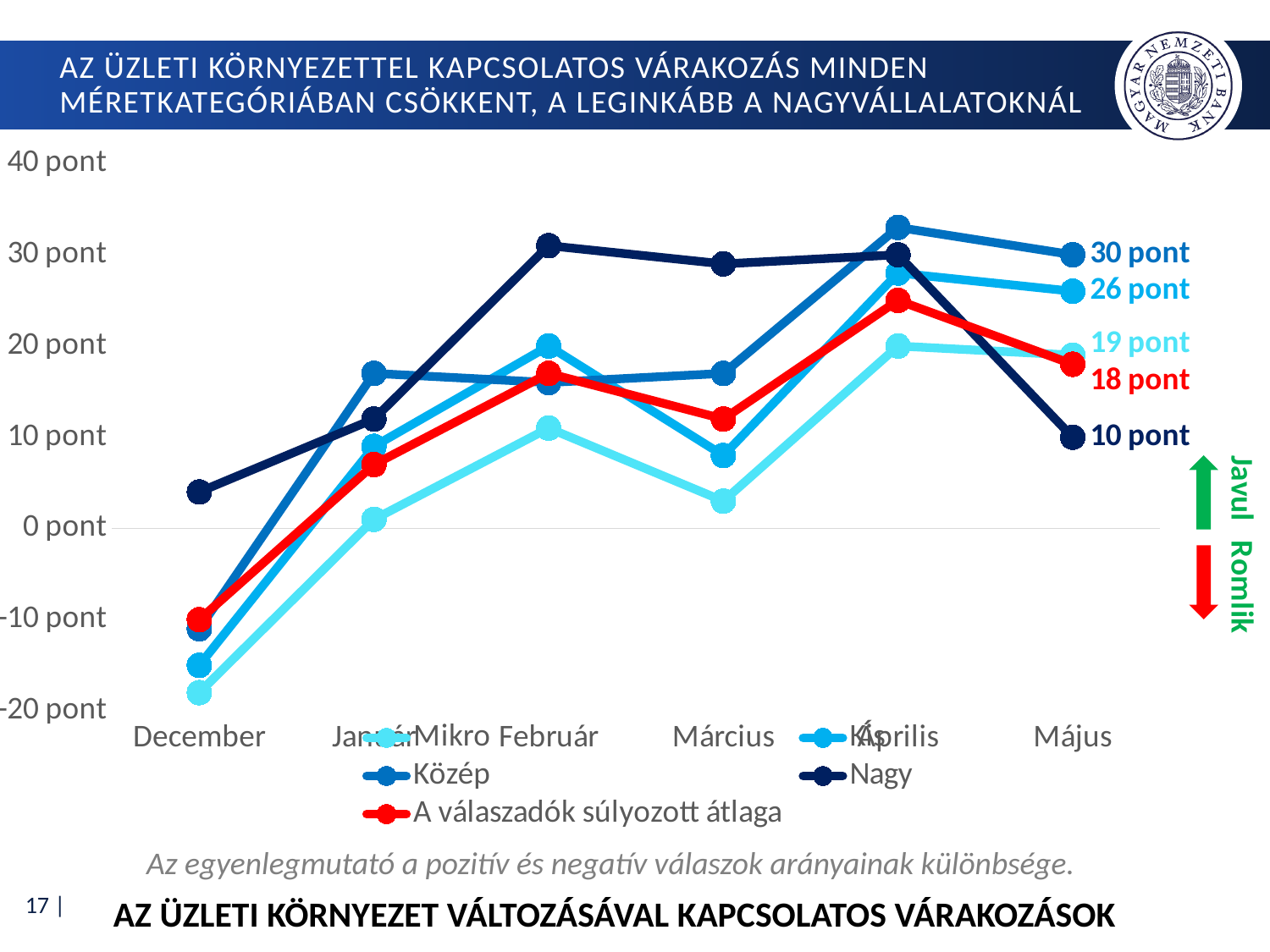
What is the difference between the Közép and Nagy values in Május? 20 pont What is the value for Nagy in Május? 10 pont How many months are shown along the x axis? 6 What is the value for A válaszadók súlyozott átlaga in Május? 18 pont How many series does the legend list? 5 What is the value for Közép in Május? 30 pont Which series has the lowest value in Május? Nagy Is the value for Mikro in December greater or less than -10 pont? less Does the Nagy series rise or fall from Április to Május? fall Is the value for Nagy in Február greater or less than 20 pont? greater What kind of chart is shown on the slide? line chart Which series has the highest value in Május? Közép